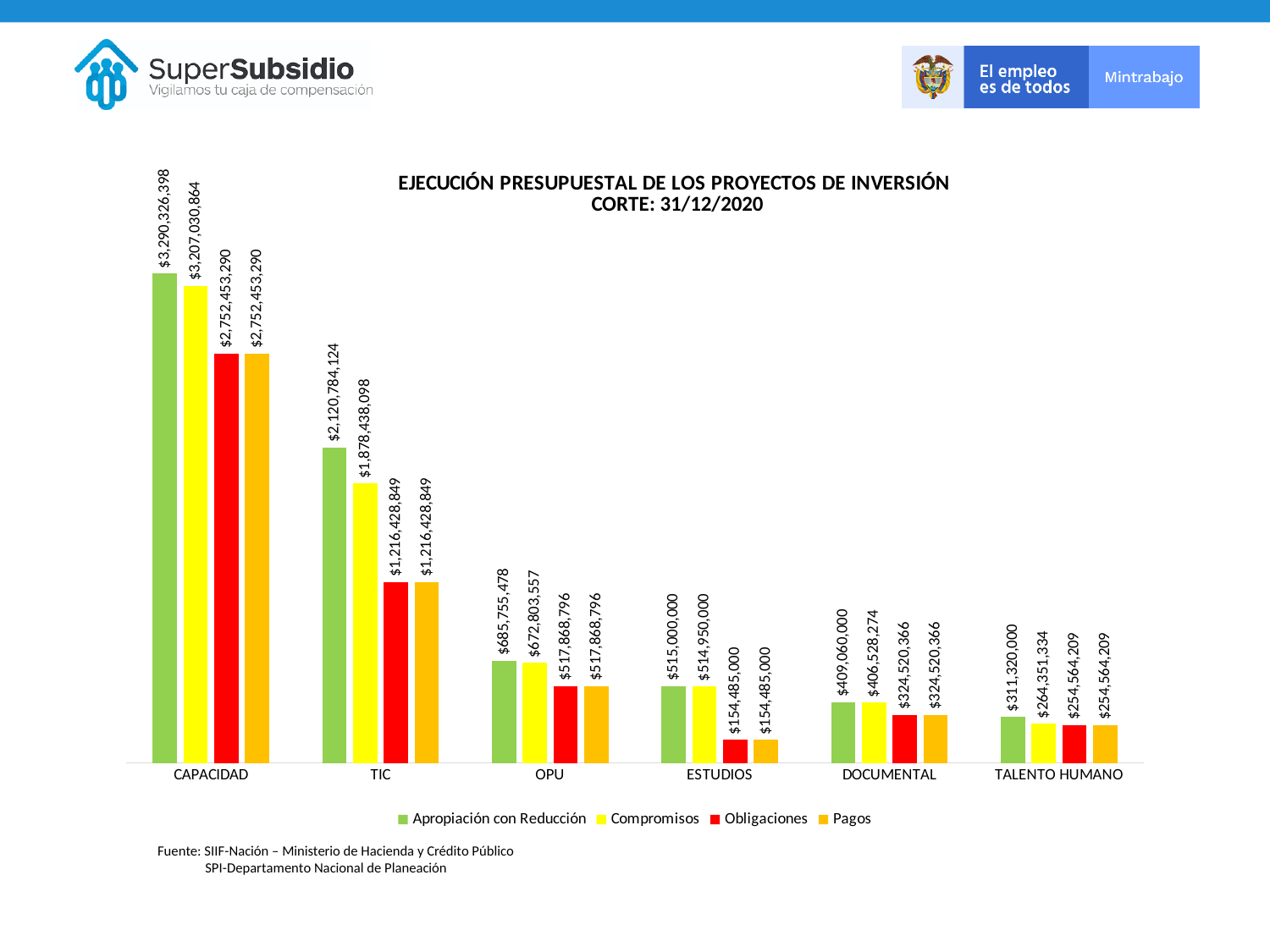
Which is larger, the Compromisos value for OPU or the Compromisos value for ESTUDIOS? OPU What is the difference between Apropiación con Reducción and Compromisos for CAPACIDAD? $83,295,534 What is the Pagos value for DOCUMENTAL? $324,520,366 How many series does the legend list? 4 How many categories are shown on the x axis? 6 What is the difference between Apropiación con Reducción and Obligaciones for TIC? $904,355,275 Which category has the lowest Pagos value? ESTUDIOS What is the Obligaciones value for ESTUDIOS? $154,485,000 Which category has the highest Apropiación con Reducción value? CAPACIDAD What is the Apropiación con Reducción value for CAPACIDAD? $3,290,326,398 What is the Compromisos value for TIC? $1,878,438,098 What kind of chart is shown on the slide? Bar chart